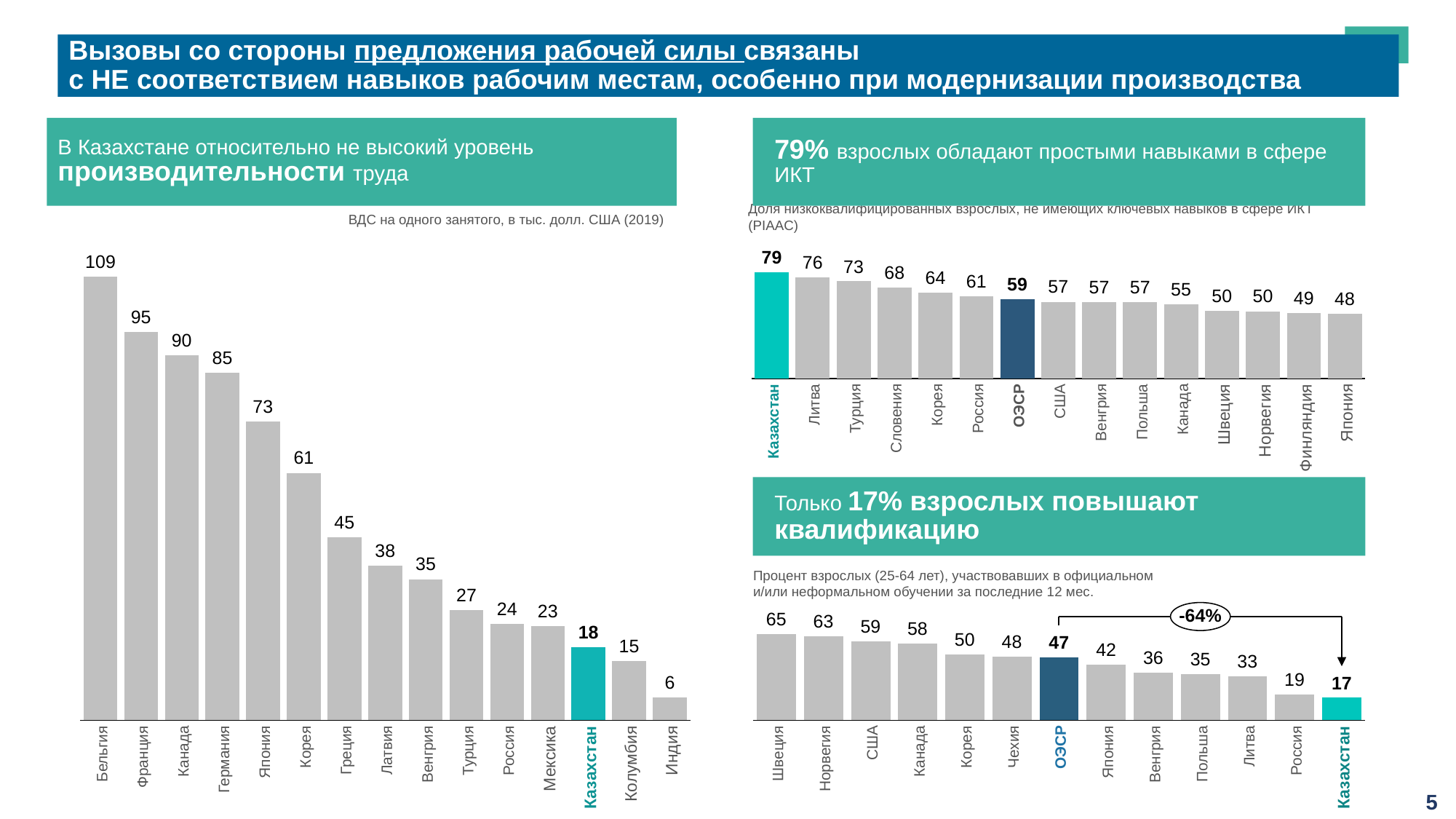
In the left chart (ВДС на одного занятого), which country has the lowest value? Индия In the left chart (ВДС на одного занятого), what is the difference between Германия and Япония? 12 In the left chart (ВДС на одного занятого), what is the value for Казахстан? 18 In the bottom-right chart (процент взрослых, участвовавших в обучении), how many countries/entities are shown? 13 What type of chart is the left chart (ВДС на одного занятого)? Bar chart In the top-right chart (доля низкоквалифицированных взрослых в сфере ИКТ), what is the value for ОЭСР? 59 In the left chart (ВДС на одного занятого), how many countries are shown? 15 In the top-right chart (доля низкоквалифицированных взрослых в сфере ИКТ), which country has the lowest value? Япония In the bottom-right chart (процент взрослых, участвовавших в обучении), which is larger, Корея or Чехия? Корея In the bottom-right chart (процент взрослых, участвовавших в обучении), what is the value for Швеция? 65 In the left chart (ВДС на одного занятого), which country has the highest value? Бельгия In the top-right chart (доля низкоквалифицированных взрослых в сфере ИКТ), what is the difference between Казахстан and ОЭСР? 20